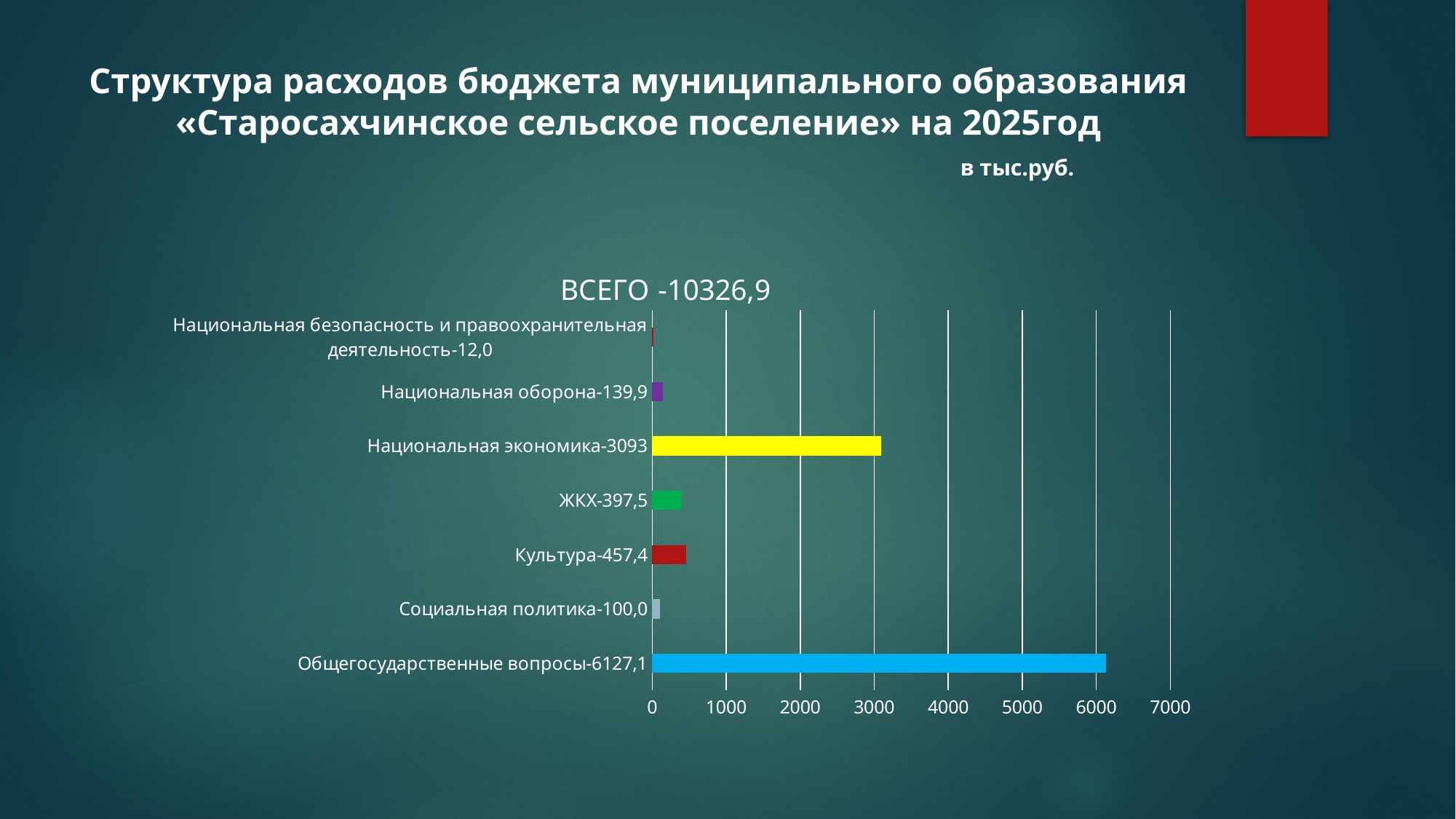
Is the value for Общегосударственные вопросы greater or less than 6000? greater What is the value for Национальная оборона? 139,9 What is the value for Культура? 457,4 What is the value for Национальная экономика? 3093 What kind of chart is shown on the slide? bar chart Which is larger, the value for ЖКХ or the value for Культура? Культура What is the chart's title? ВСЕГО -10326,9 What unit is stated for the values on the slide? в тыс.руб. Which category has the highest value? Общегосударственные вопросы What is the difference between the values for Общегосударственные вопросы and Национальная экономика? 3034,1 How many categories does the chart show? 7 Which category has the lowest value? Национальная безопасность и правоохранительная деятельность